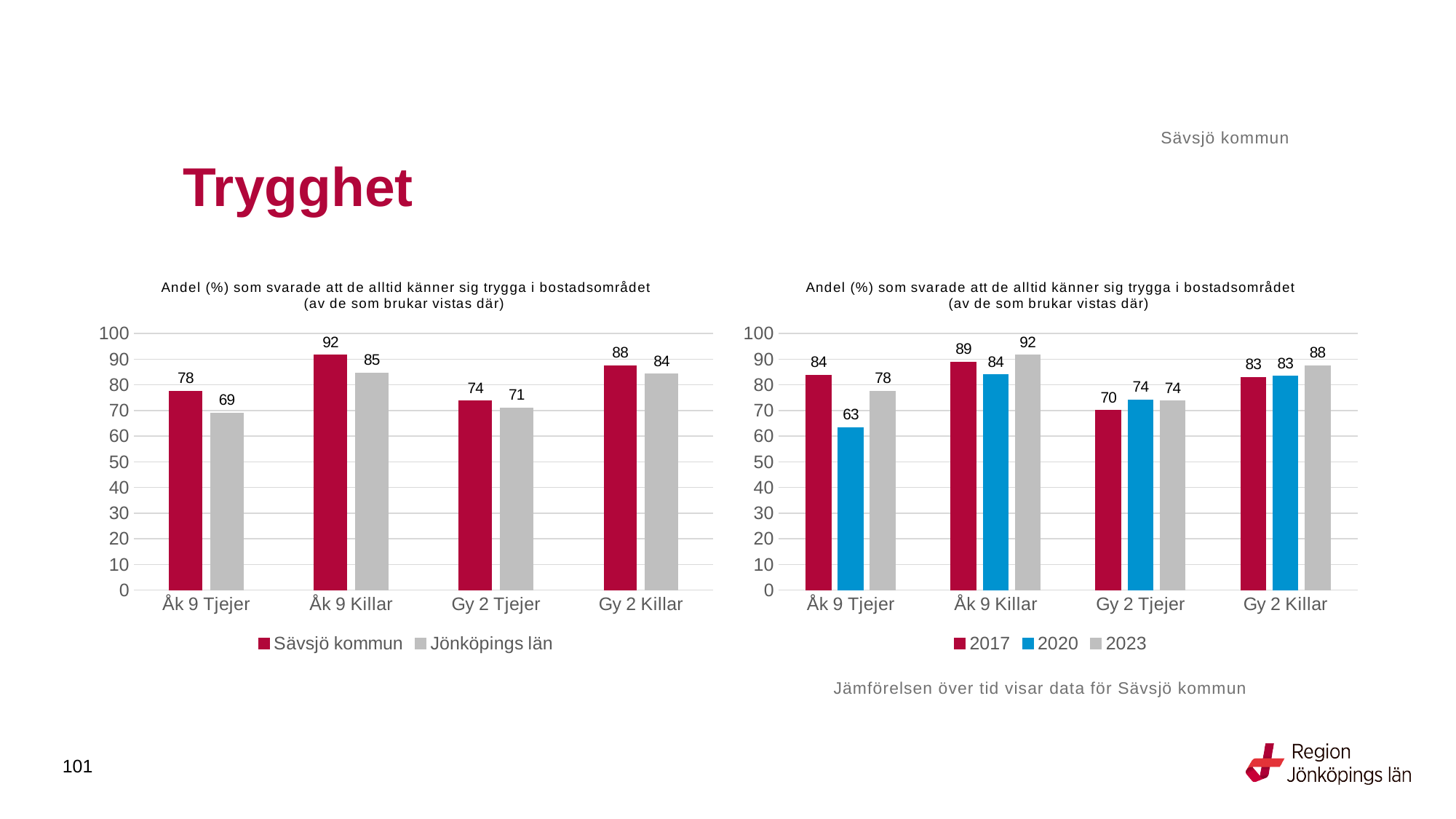
In the left chart, how many series does the legend list? 2 In the left chart, what is the value for Jönköpings län for Gy 2 Tjejer? 71 In the left chart, which category has the lowest value for Jönköpings län? Åk 9 Tjejer In the right chart, what is the value for 2023 for Gy 2 Killar? 88 In the left chart, what is the value for Sävsjö kommun for Åk 9 Killar? 92 In the right chart, which is larger for Gy 2 Tjejer: the 2017 value or the 2020 value? 2020 In the left chart, what is the difference between Sävsjö kommun and Jönköpings län for Åk 9 Tjejer? 9 In the right chart, what is the value for 2020 for Åk 9 Tjejer? 63 In the right chart, how many categories are shown on the x axis? 4 In the right chart, which category has the highest value for 2023? Åk 9 Killar In the right chart, what is the difference between the 2023 and 2017 values for Åk 9 Tjejer? -6 What kind of chart is the right chart? Bar chart